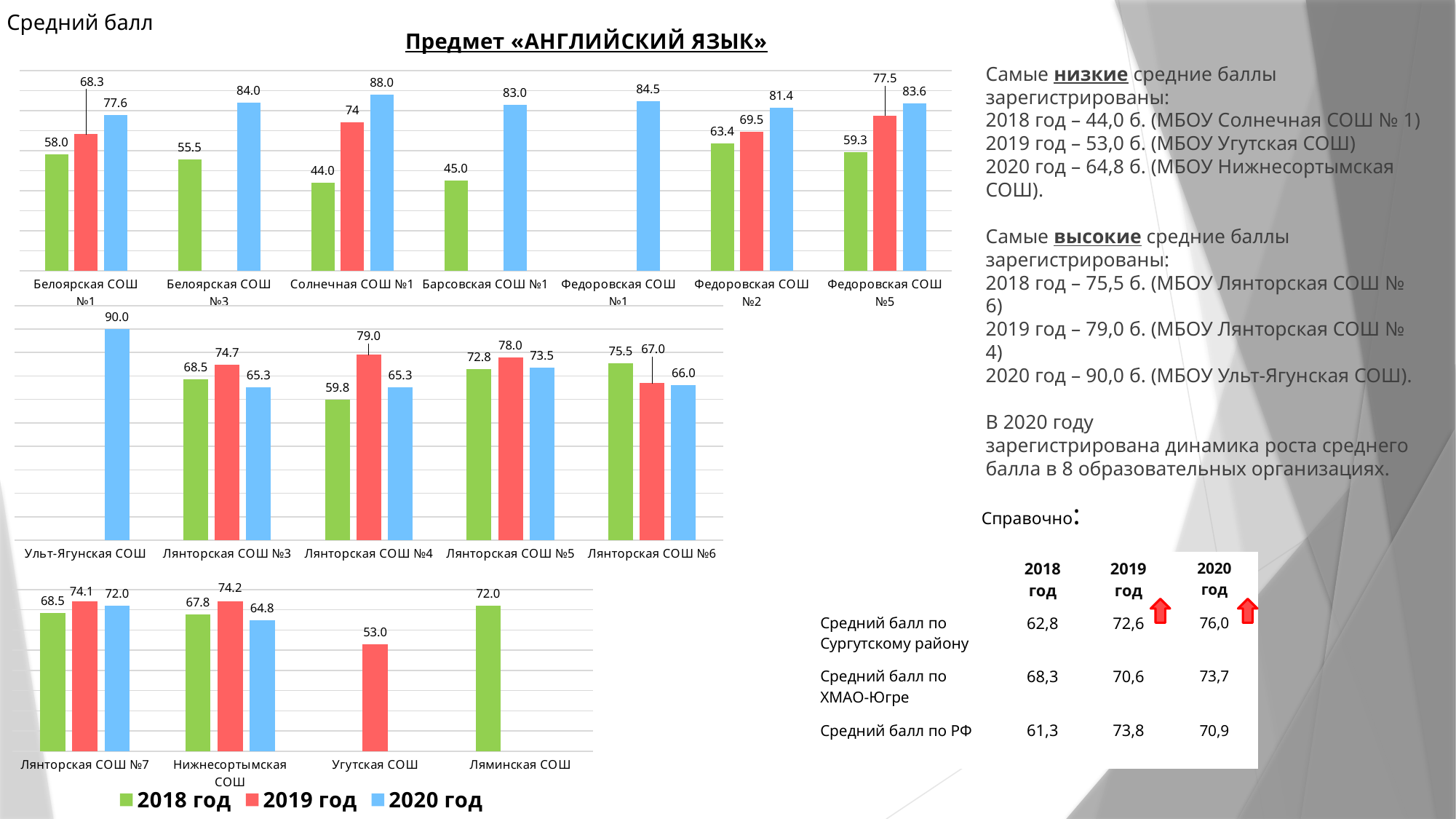
In the top chart, what is the 2020 год value for Солнечная СОШ №1? 88.0 In the top chart, what is the 2018 год value for Белоярская СОШ №3? 55.5 What type of chart is used on this slide? Bar chart In the bottom chart, what is the 2019 год value for Угутская СОШ? 53.0 In the middle chart, which school has the highest 2019 год value? Лянторская СОШ №4 In the middle chart, what is the 2020 год value for Ульт-Ягунская СОШ? 90.0 How many schools are shown on the x axis of the bottom chart? 4 In the bottom chart, what is the difference between the 2019 год and 2020 год values for Нижнесортымская СОШ? 9.4 In the top chart, what is the difference between the 2020 год and 2018 год values for Белоярская СОШ №1? 19.6 In the top chart, which school has the lowest 2018 год value? Солнечная СОШ №1 In the middle chart, is the 2018 год value for Лянторская СОШ №6 larger or smaller than its 2019 год value? larger How many series does the legend list? 3